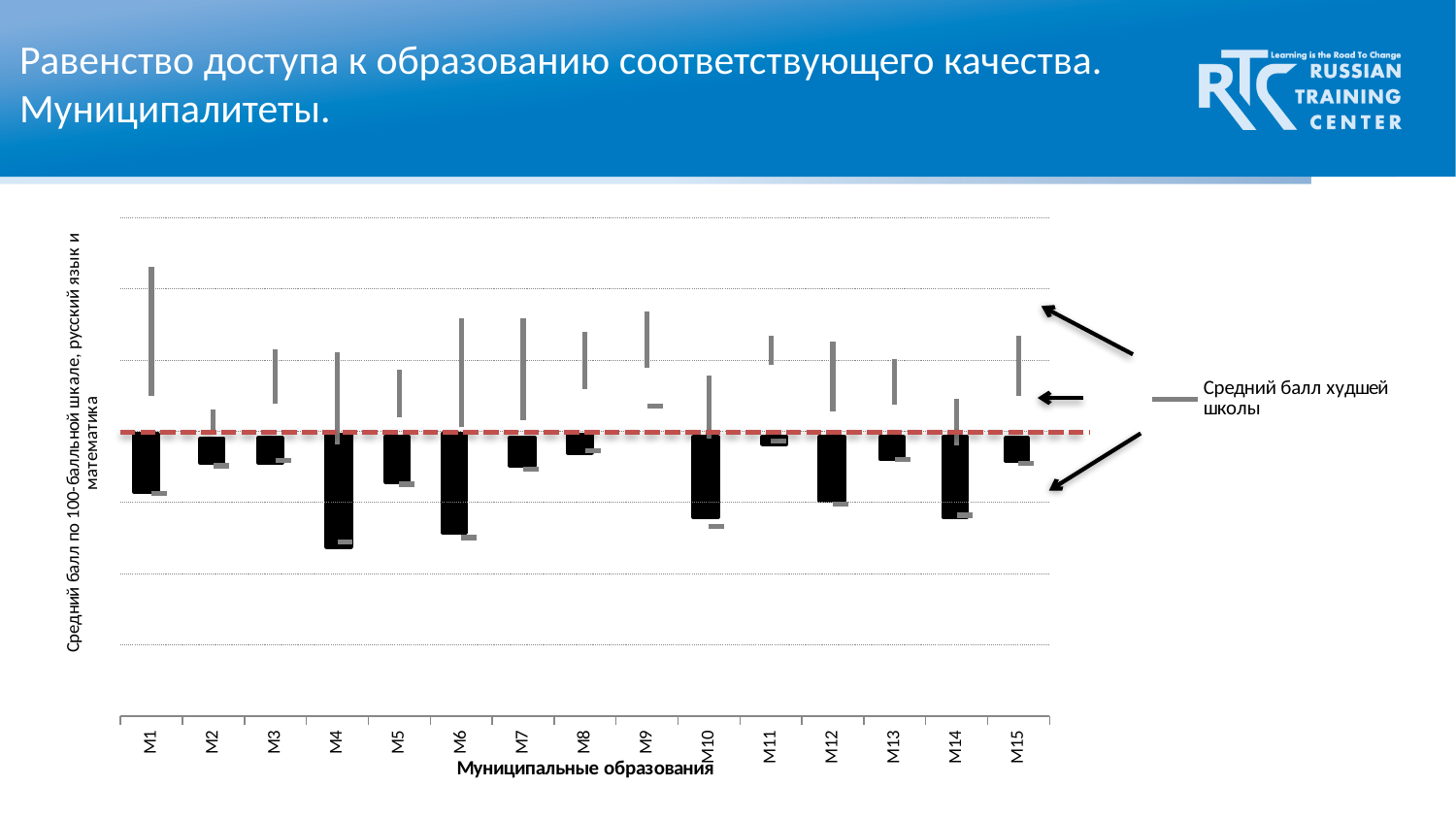
Which has the longer black bar below the dashed line, M14 or M13? M14 What does the legend entry next to the grey marker say? Средний балл худшей школы Which has the taller grey bar above the dashed line, M1 or M2? M1 Which has the taller grey bar above the dashed line, M6 or M9? M6 What kind of chart is shown on the slide? bar chart What is the label of the x axis of the chart? Муниципальные образования How many municipalities are shown on the x axis of the chart? 15 Which municipality has the tallest grey bar above the red dashed line? M1 Which municipality has the black bar extending furthest below the red dashed line? M4